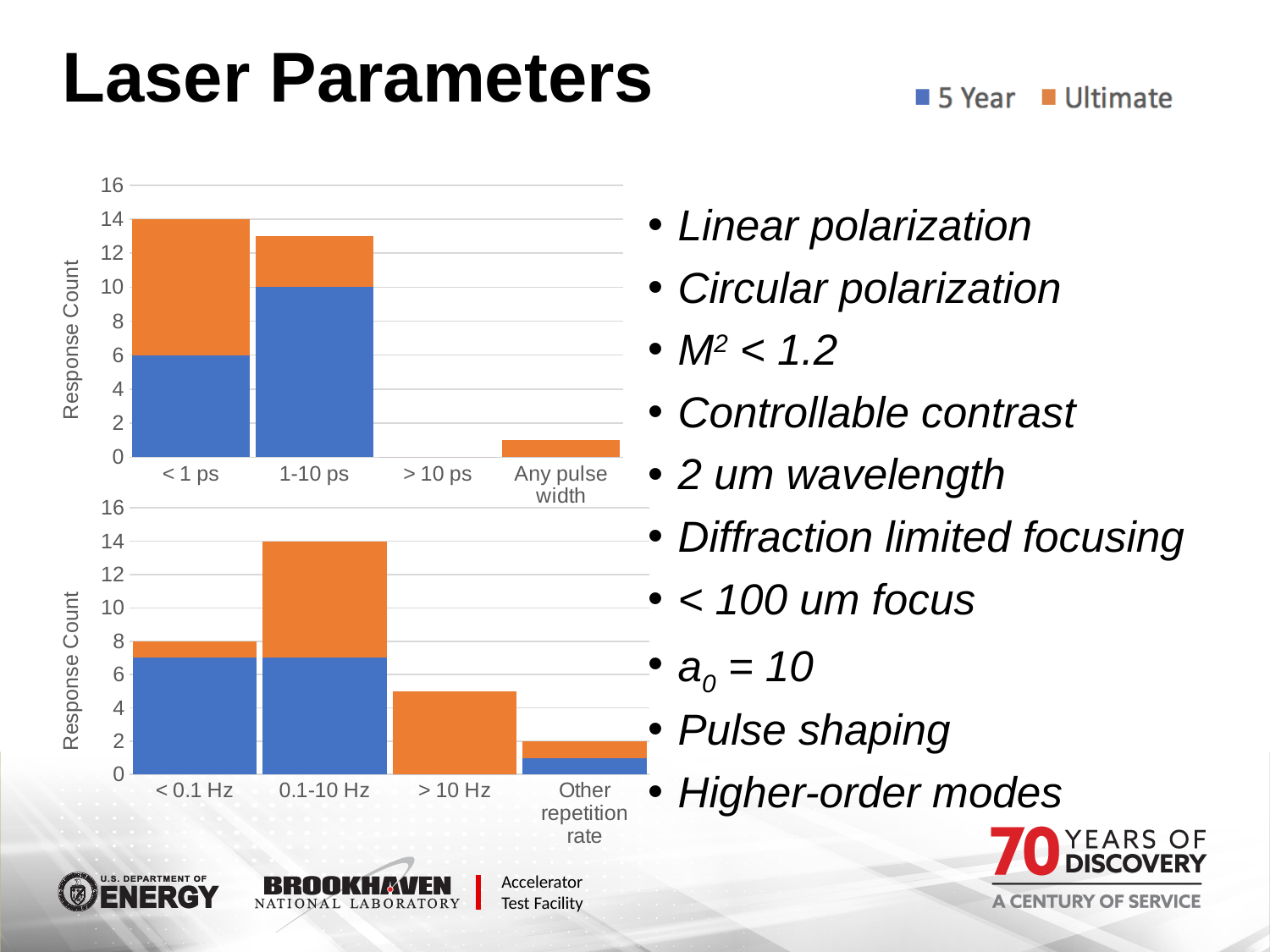
In the bottom chart, what is the total response count for the 0.1-10 Hz bar? 14 In the bottom chart, is the total response count for > 10 Hz greater or less than 4? greater What is the y-axis label of the charts? Response Count In the top chart, what is the 5 Year response count for 1-10 ps? 10 In the top chart, which pulse width category has the lowest total response count? > 10 ps How many categories are shown on the x axis of the bottom chart? 4 In the top chart, which pulse width category has the highest total response count? < 1 ps What kind of chart is the top chart on the slide? stacked bar chart In the bottom chart, which has the larger total response count, < 0.1 Hz or Other repetition rate? < 0.1 Hz In the bottom chart, which repetition rate category has the highest total response count? 0.1-10 Hz How many series does the legend list? 2 In the top chart, what is the total response count for the < 1 ps bar? 14